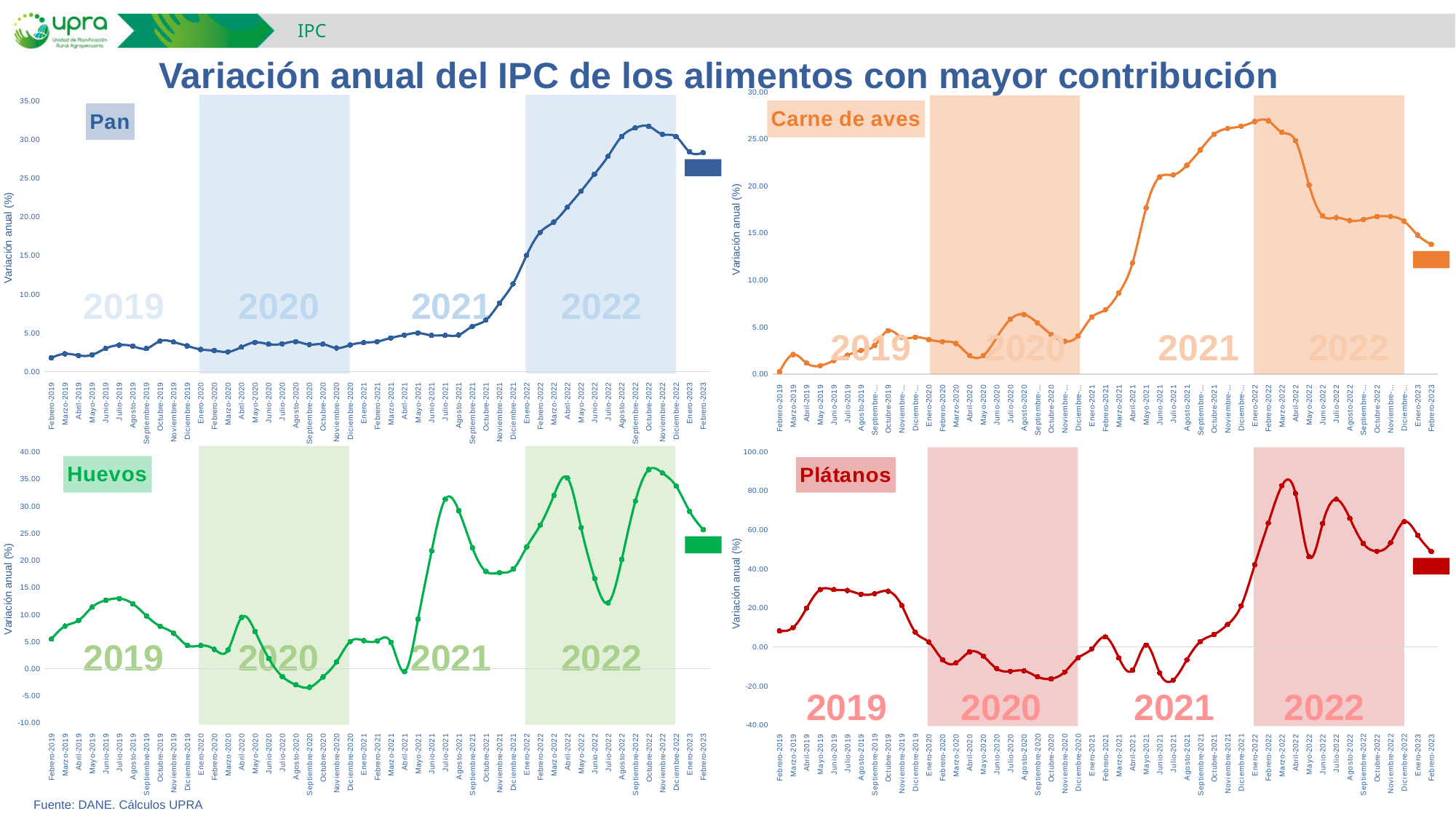
In the 'Plátanos' chart, is the value for Marzo-2022 greater or less than 80.00? greater In the 'Pan' chart, is the value for Febrero-2019 greater or less than 5.00? less What kind of chart is the 'Pan' chart? line chart In the 'Huevos' chart, is the value for Febrero-2023 greater or less than 20.00? greater In the 'Pan' chart, do the values rise or fall from Enero-2022 to Octubre-2022? rise How many charts are shown on the slide? 4 In the 'Pan' chart, which is larger, the value for Octubre-2022 or the value for Febrero-2019? Octubre-2022